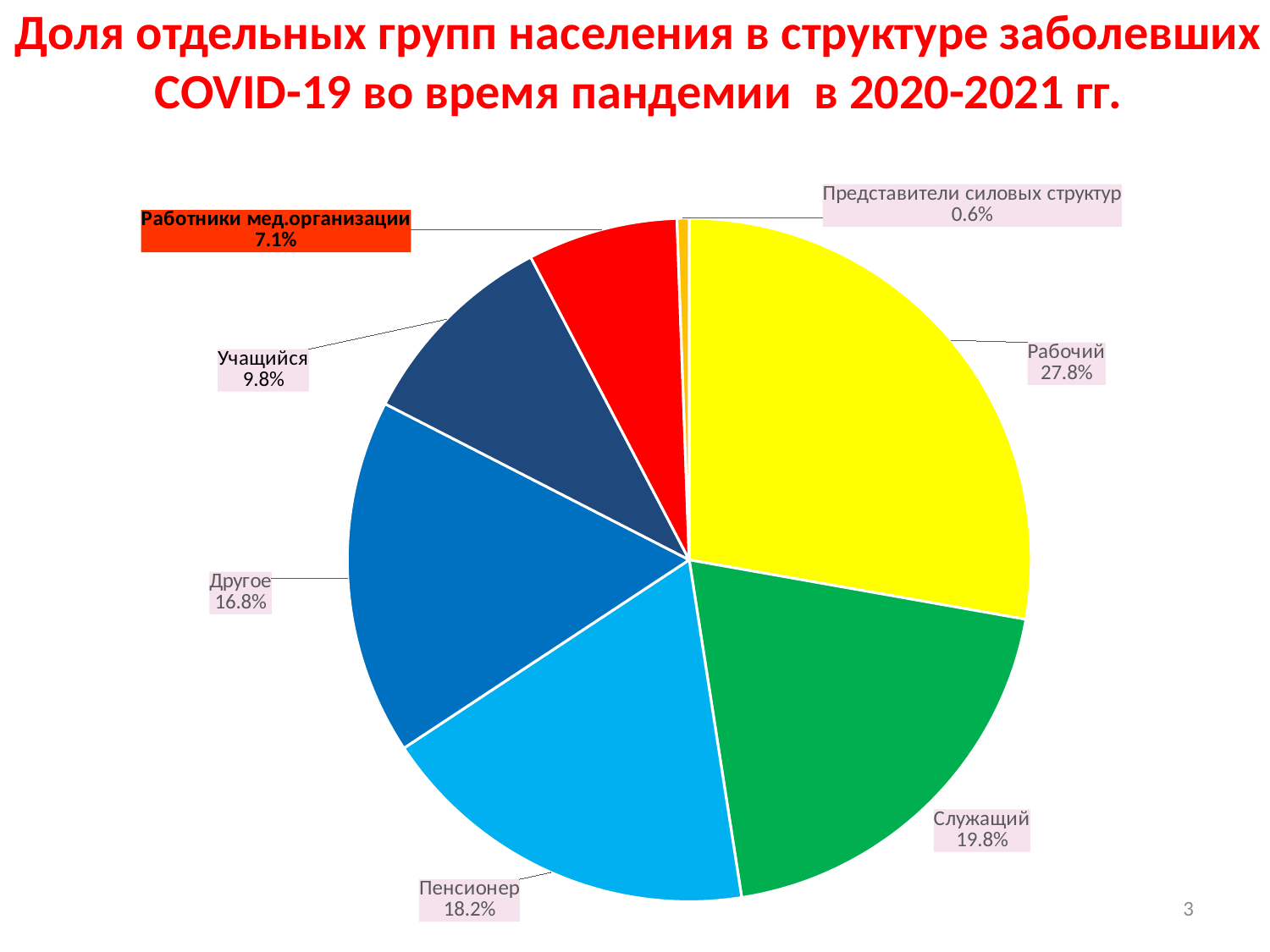
What share of the pie does Рабочий have? 27.8% What is the value shown for Работники мед.организации? 7.1% What is the difference between the shares of Рабочий and Работники мед.организации? 20.7% What is the difference between the shares of Служащий and Пенсионер? 1.6% Which category has the largest share of the pie? Рабочий What is the value shown for Пенсионер? 18.2% Which category has the smallest share of the pie? Представители силовых структур Which is larger, the share for Другое or the share for Учащийся? Другое How many slices does the pie chart have? 7 What kind of chart is shown on the slide? pie chart What is the value shown for Представители силовых структур? 0.6% What colour is the slice for Рабочий? yellow